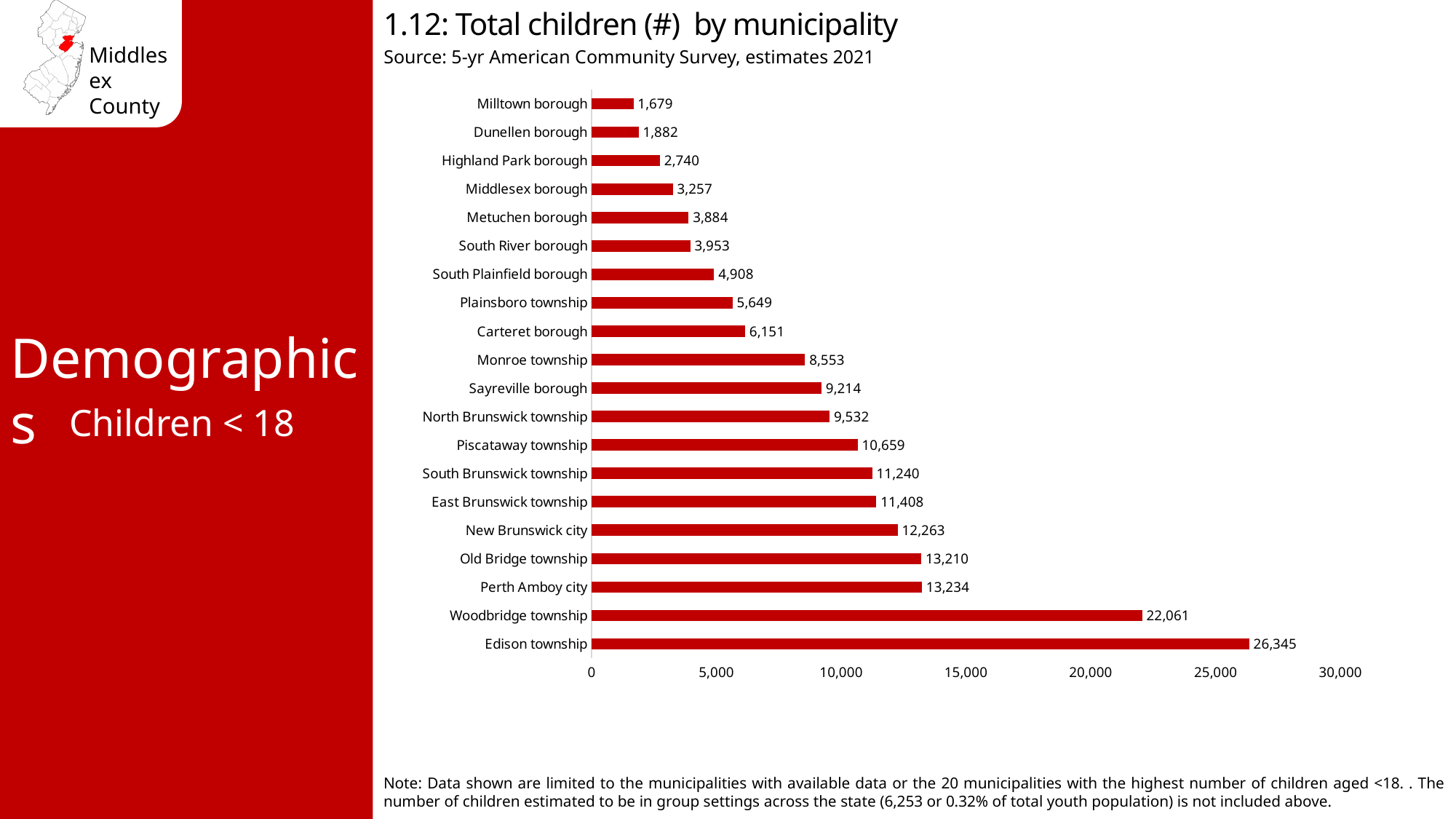
Which municipality has the highest number of children? Edison township What type of chart is used to show total children by municipality? bar chart What is the difference in the number of children between Edison township and Woodbridge township? 4,284 Is the value for Woodbridge township greater or less than 20,000? greater What is the total number of children in Plainsboro township? 5,649 What is the total number of children in Edison township? 26,345 Which municipality has the lowest number of children? Milltown borough How many municipalities are shown in the chart? 20 Which has more children, New Brunswick city or Piscataway township? New Brunswick city What is the difference in the number of children between Sayreville borough and Monroe township? 661 What is the source of the data shown in the chart? 5-yr American Community Survey, estimates 2021 What is the total number of children in Perth Amboy city? 13,234